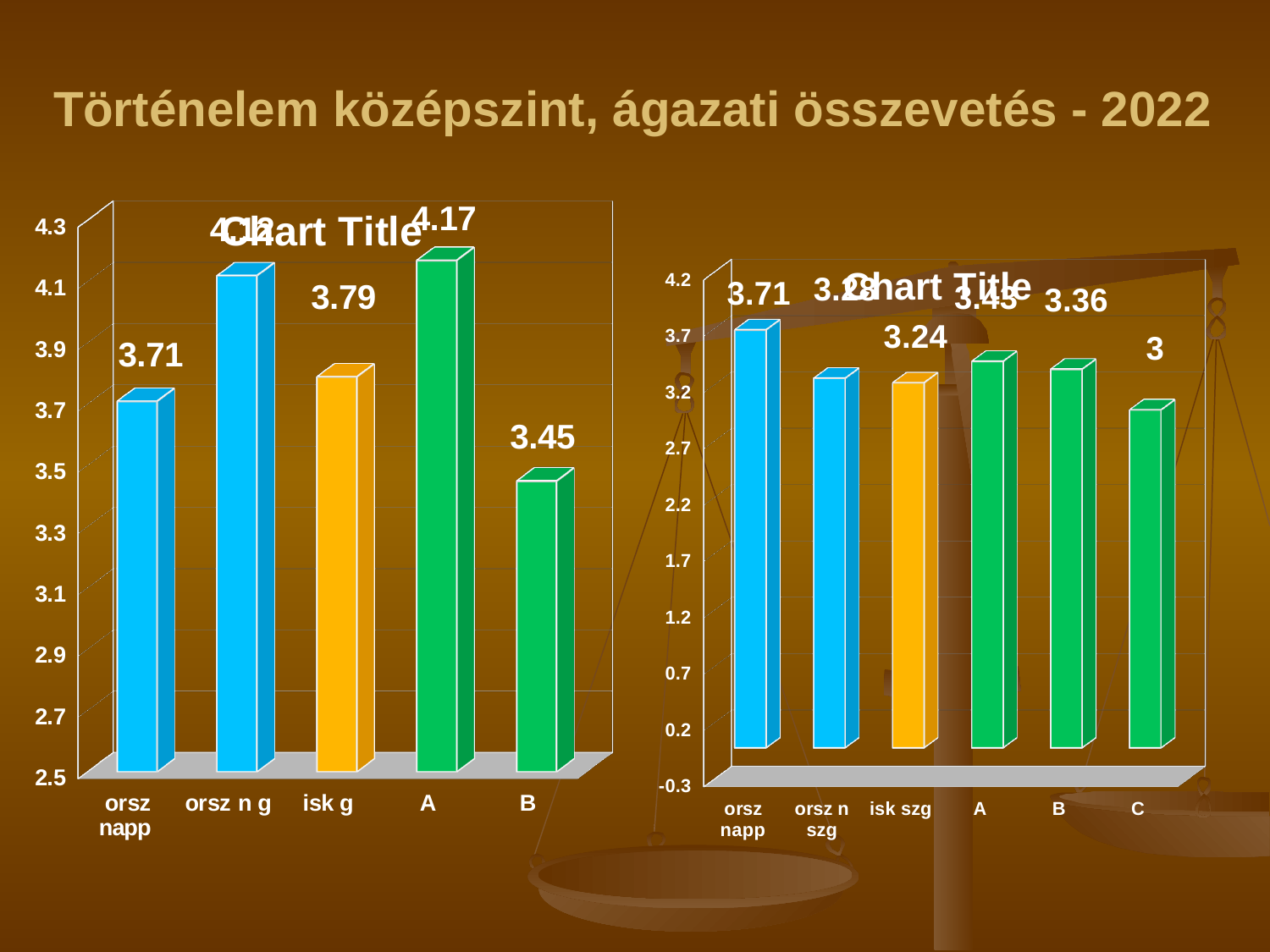
In the left chart, what is the value for B? 3.45 In the right chart, which category has the lowest value? C In the left chart, what is the difference between the values for A and B? 0.72 In the right chart, what is the value for isk szg? 3.24 In the right chart, what is the value for C? 3 In the right chart, which is larger, the value for isk szg or the value for B? B In the left chart, what is the value for isk g? 3.79 In the left chart, what is the value for orsz napp? 3.71 In the left chart, which category has the lowest value? B How many categories are shown in the right chart? 6 In the right chart, which category has the highest value? orsz napp What kind of chart is the left chart? bar chart